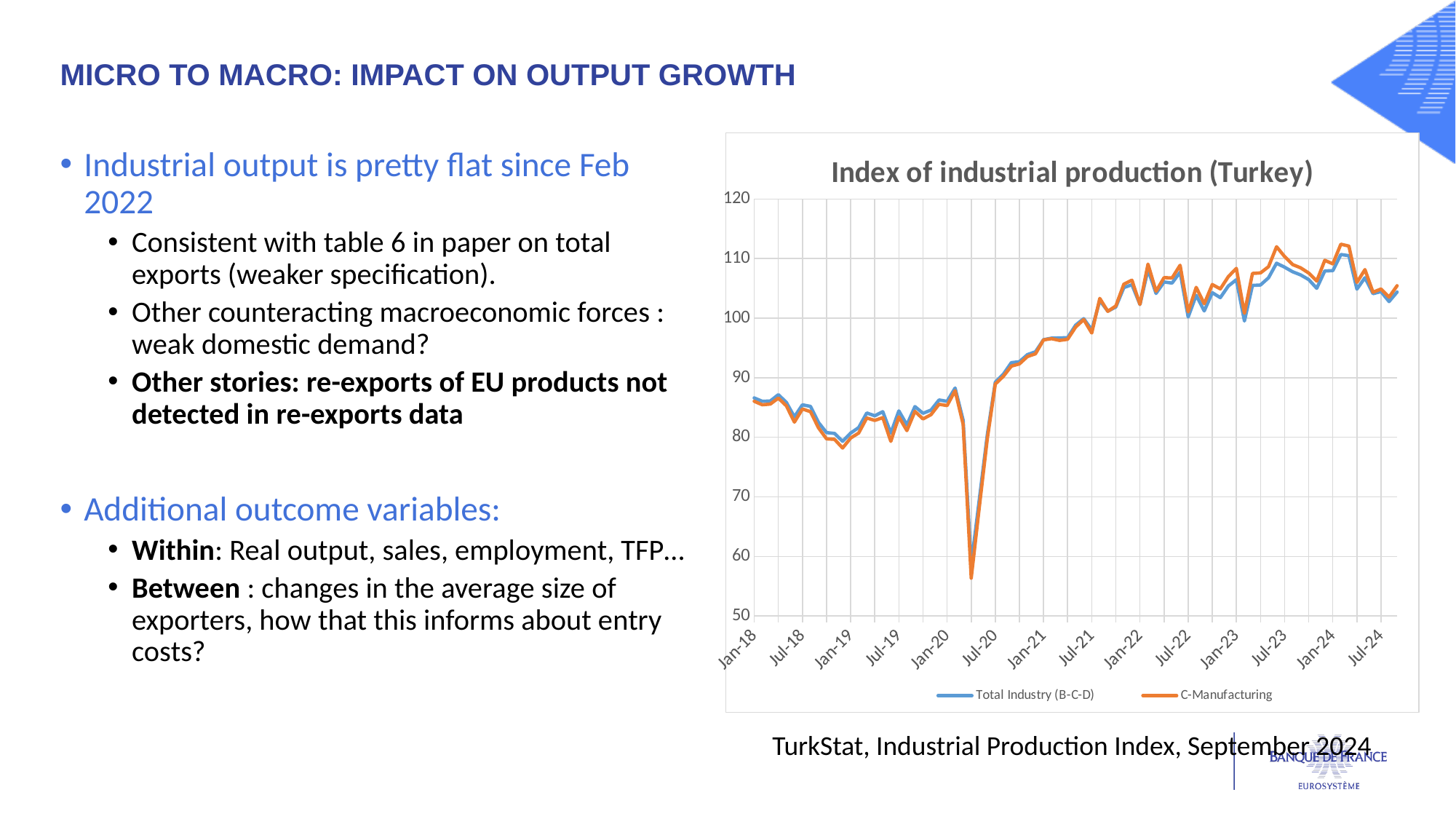
Is the value of C-Manufacturing at its lowest point near Jul-20 greater or less than 60? less Which series is drawn in orange in the chart? C-Manufacturing Is the value of Total Industry (B-C-D) at Jan-18 greater or less than 80? greater Is the value of Total Industry (B-C-D) at Jan-22 greater or less than 100? greater How many series does the legend of the chart list? 2 How many date labels are shown on the x axis of the chart? 14 Between Jul-20 and Jan-22, do the series generally rise or fall? rise What is the title of the chart? Index of industrial production (Turkey) Which is larger for Total Industry (B-C-D): the value at Jan-18 or the value at Jan-24? Jan-24 Around which x-axis label does the C-Manufacturing series reach its lowest value? Jul-20 What kind of chart is shown on the slide? line chart